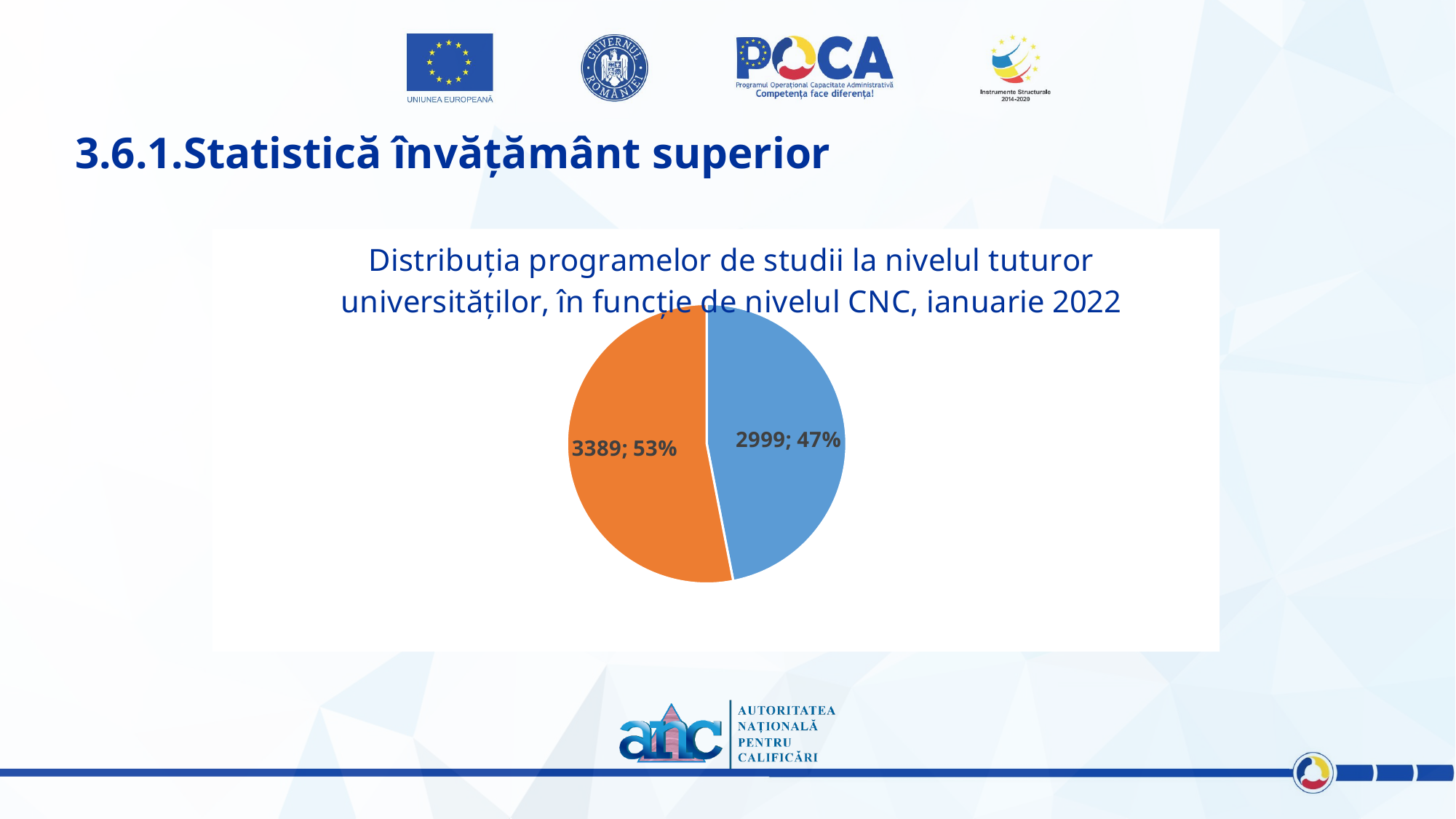
What share of the pie does the orange slice represent? 53% How many slices does the pie chart have? 2 What is the total of the two values shown on the pie chart? 6388 What value is printed on the orange slice of the pie chart? 3389 Which slice of the pie chart is larger, the orange one or the blue one? the orange one What share of the pie does the blue slice represent? 47% What is the title of the pie chart? Distribuția programelor de studii la nivelul tuturor universităților, în funcție de nivelul CNC, ianuarie 2022 What value is printed on the blue slice of the pie chart? 2999 Which slice of the pie chart has the smallest value? the blue slice (2999) Is the value of the blue slice greater or less than 3000? less What is the difference between the values of the orange slice and the blue slice? 390 What kind of chart is shown on the slide? pie chart